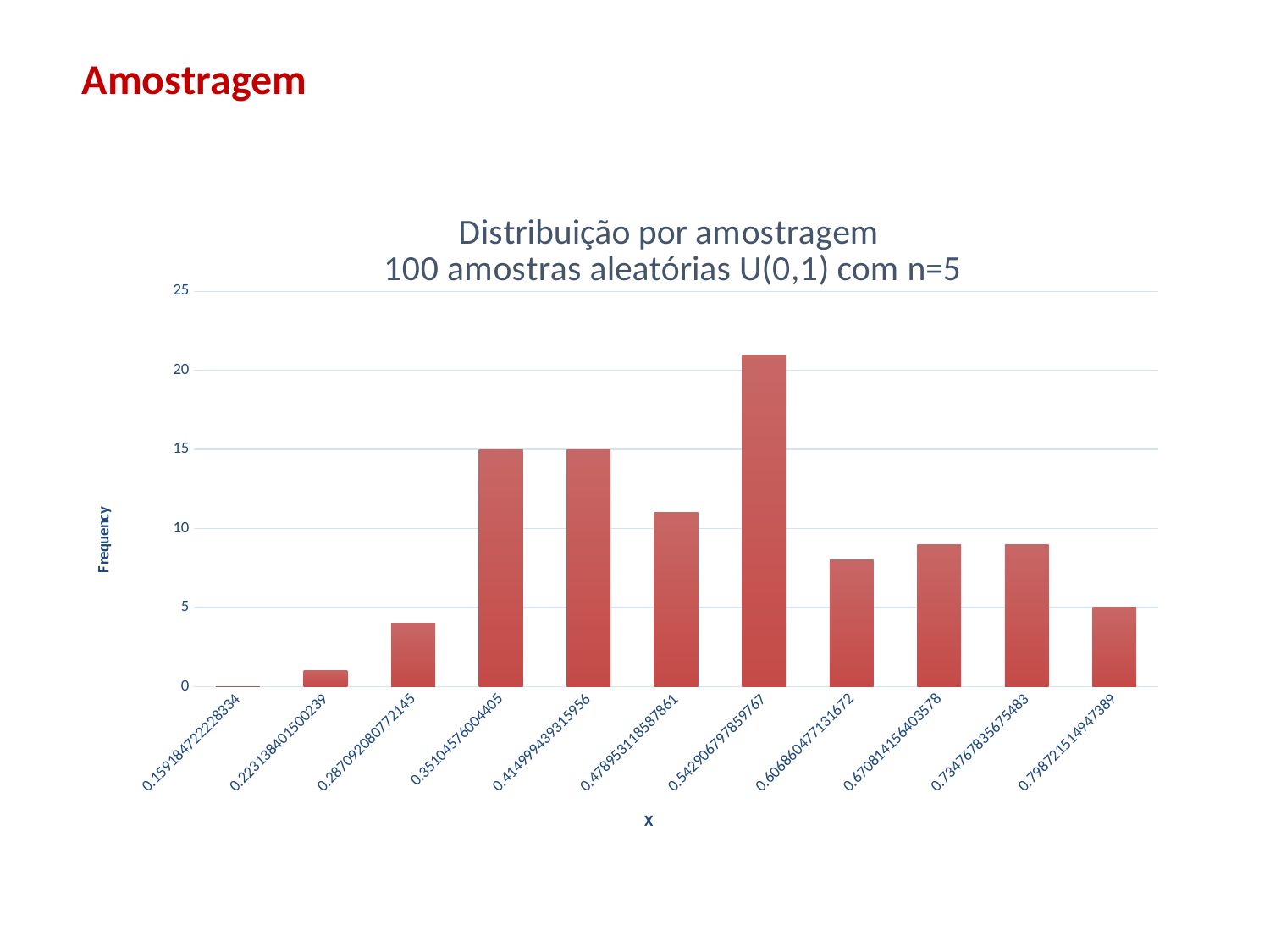
How many bars (categories) are plotted in the chart? 11 What is the frequency for the category 0.351045760044405? 15 What is the label of the vertical axis? Frequency Is the frequency for 0.287092080772145 greater or less than 5? less What kind of chart is shown on the slide? bar chart What is the frequency for the category 0.798721514947389? 5 What is the title of the chart? Distribuição por amostragem 100 amostras aleatórias U(0,1) com n=5 Is the frequency for 0.542906797859767 greater or less than 20? greater Which has a higher frequency, 0.478953118587861 or 0.606860477131672? 0.478953118587861 Is the frequency for 0.670814156403578 greater or less than 10? less Which category has the highest frequency? 0.542906797859767 Which category has the lowest frequency? 0.159184722228334